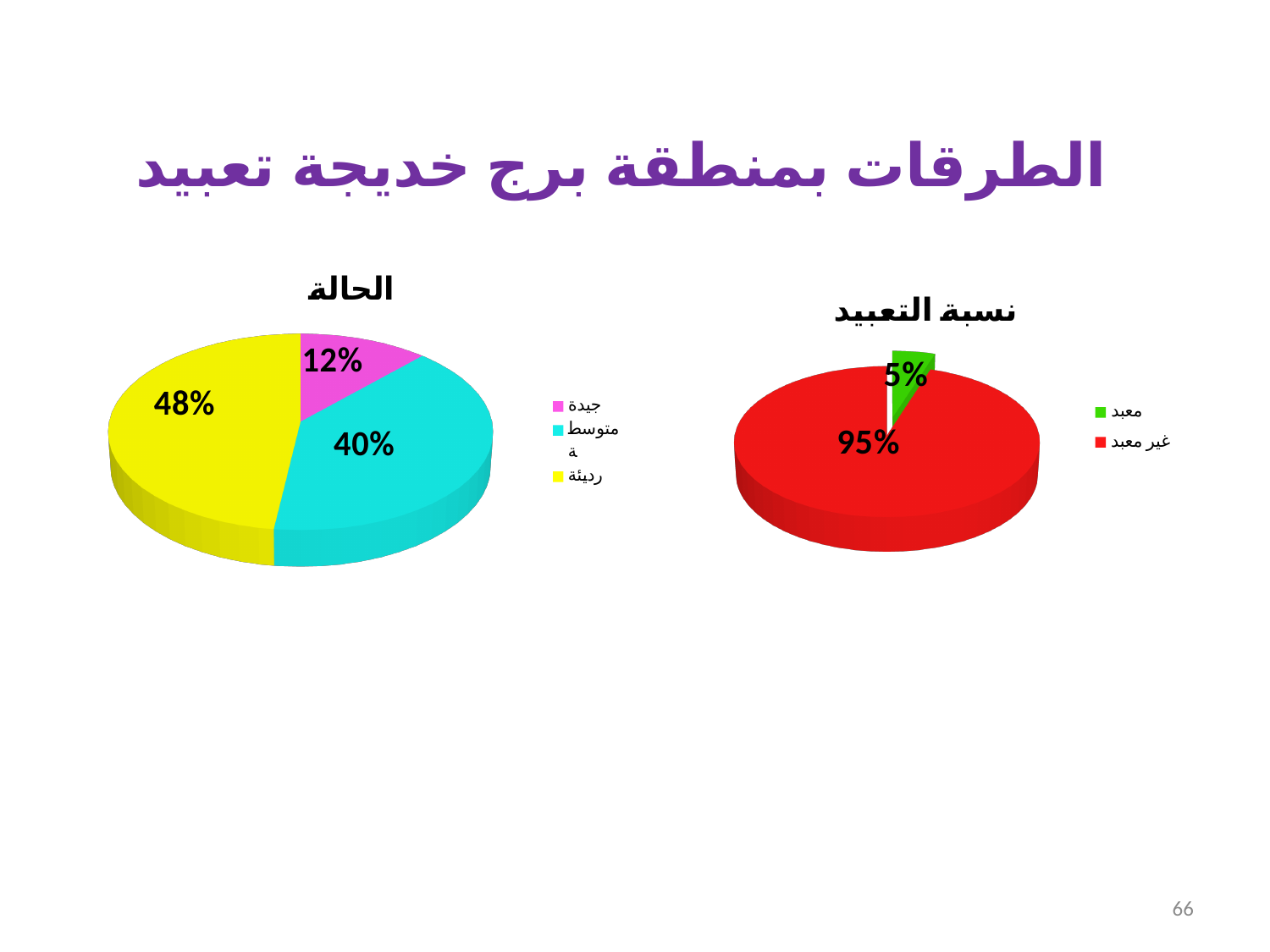
In the chart titled "الحالة", which category has the smallest share? جيدة In the chart titled "الحالة", which category has the largest share? رديئة In the chart titled "الحالة", what is the difference between the shares of "رديئة" and "جيدة"? 36% In the chart titled "الحالة", what percentage is shown for "رديئة"? 48% In the chart titled "نسبة التعبيد", what percentage is shown for "معبد"? 5% What type of chart is the chart titled "نسبة التعبيد"? Pie chart In the chart titled "الحالة", what percentage is shown for "جيدة"? 12% In the chart titled "الحالة", what colour is the "رديئة" slice? Yellow In the chart titled "نسبة التعبيد", which category is larger, "معبد" or "غير معبد"? غير معبد In the chart titled "الحالة", how many slices does the pie have? 3 In the chart titled "الحالة", what percentage is shown for "متوسطة"? 40% In the chart titled "نسبة التعبيد", what percentage is shown for "غير معبد"? 95%